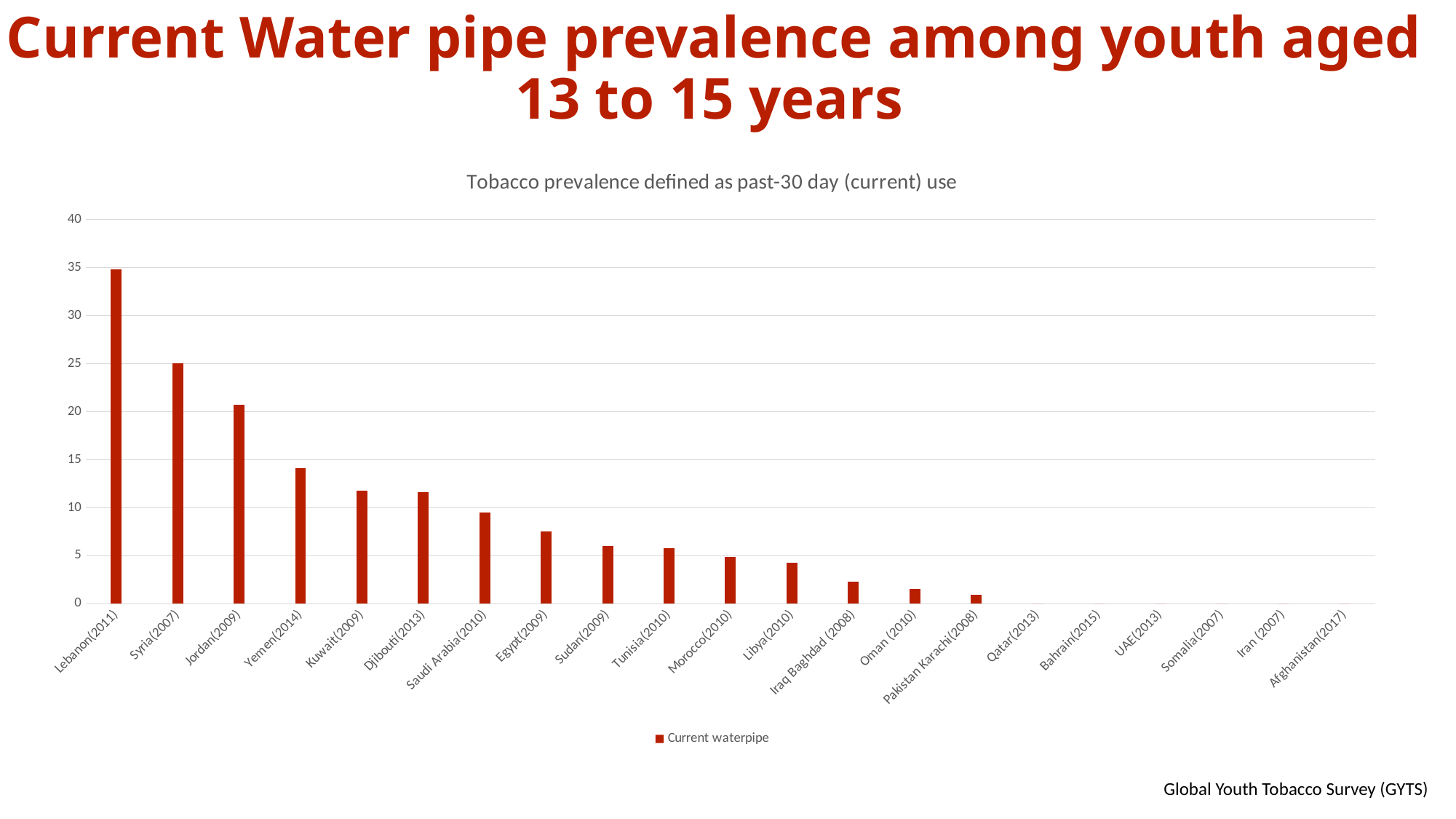
Is the value for Kuwait(2009) greater or less than 10? greater Is the value for Iraq Baghdad (2008) greater or less than 5? less What kind of chart is shown on the slide? bar chart How many countries/categories are shown on the x axis? 21 Is the value for Lebanon(2011) greater or less than 30? greater Which country has the highest current waterpipe prevalence? Lebanon(2011) What is the name of the series shown in the legend? Current waterpipe How many series does the legend list? 1 Do the values rise or fall moving from left to right along the x axis? fall Which has a higher value, Syria(2007) or Jordan(2009)? Syria(2007)